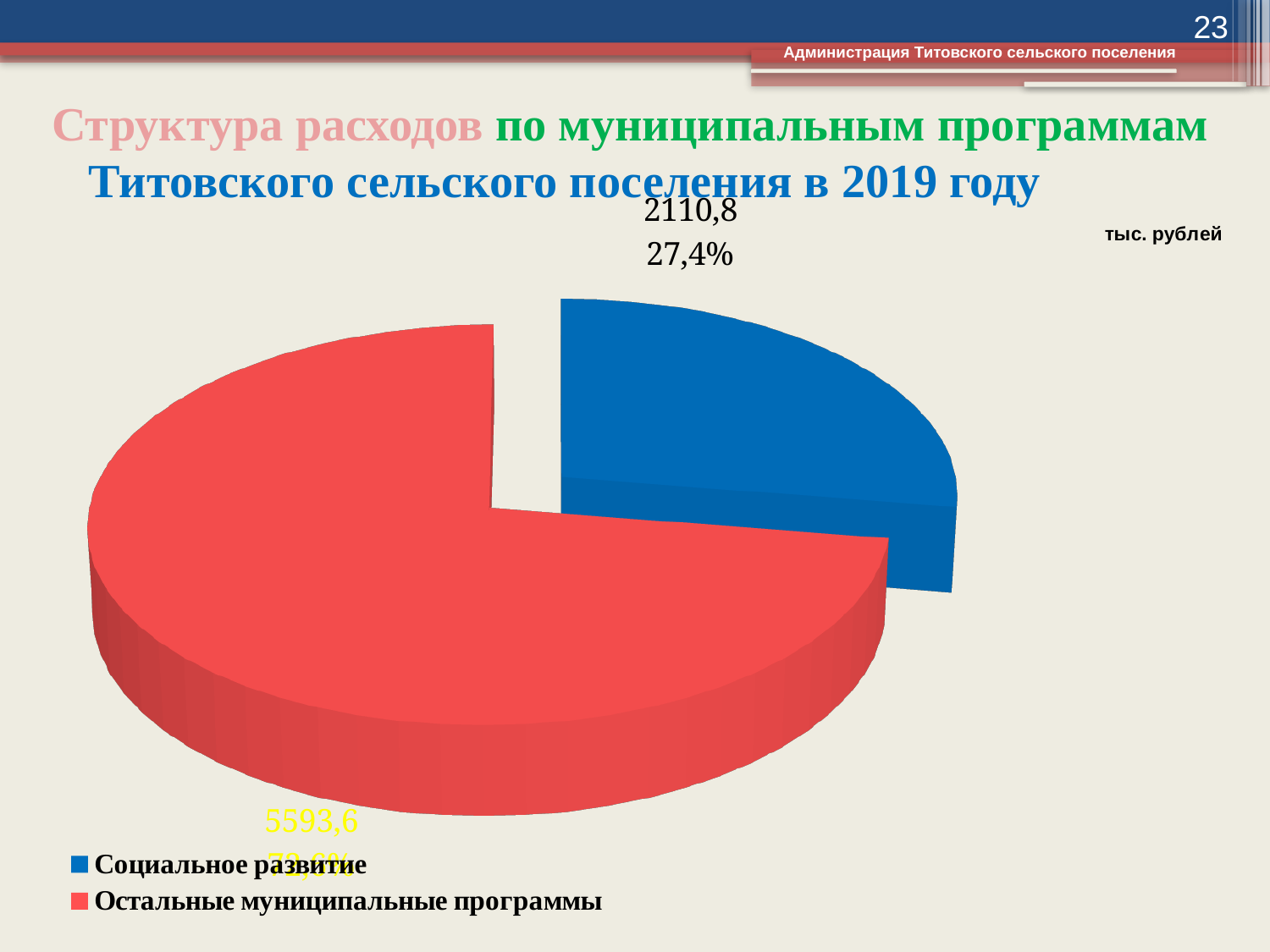
Which category has the smallest slice of the pie? Социальное развитие What is the value for Остальные муниципальные программы? 5593,6 Which category has the largest slice of the pie? Остальные муниципальные программы What share of the pie does Социальное развитие represent? 27,4% What is the difference between the values for Остальные муниципальные программы and Социальное развитие? 3482,8 What colour is the slice for Социальное развитие? blue How many entries does the legend list? 2 How many slices does the pie chart have? 2 In what units are the values on the chart given? тыс. рублей What is the value for Социальное развитие? 2110,8 Which is larger: Социальное развитие or Остальные муниципальные программы? Остальные муниципальные программы What kind of chart is shown on the slide? pie chart